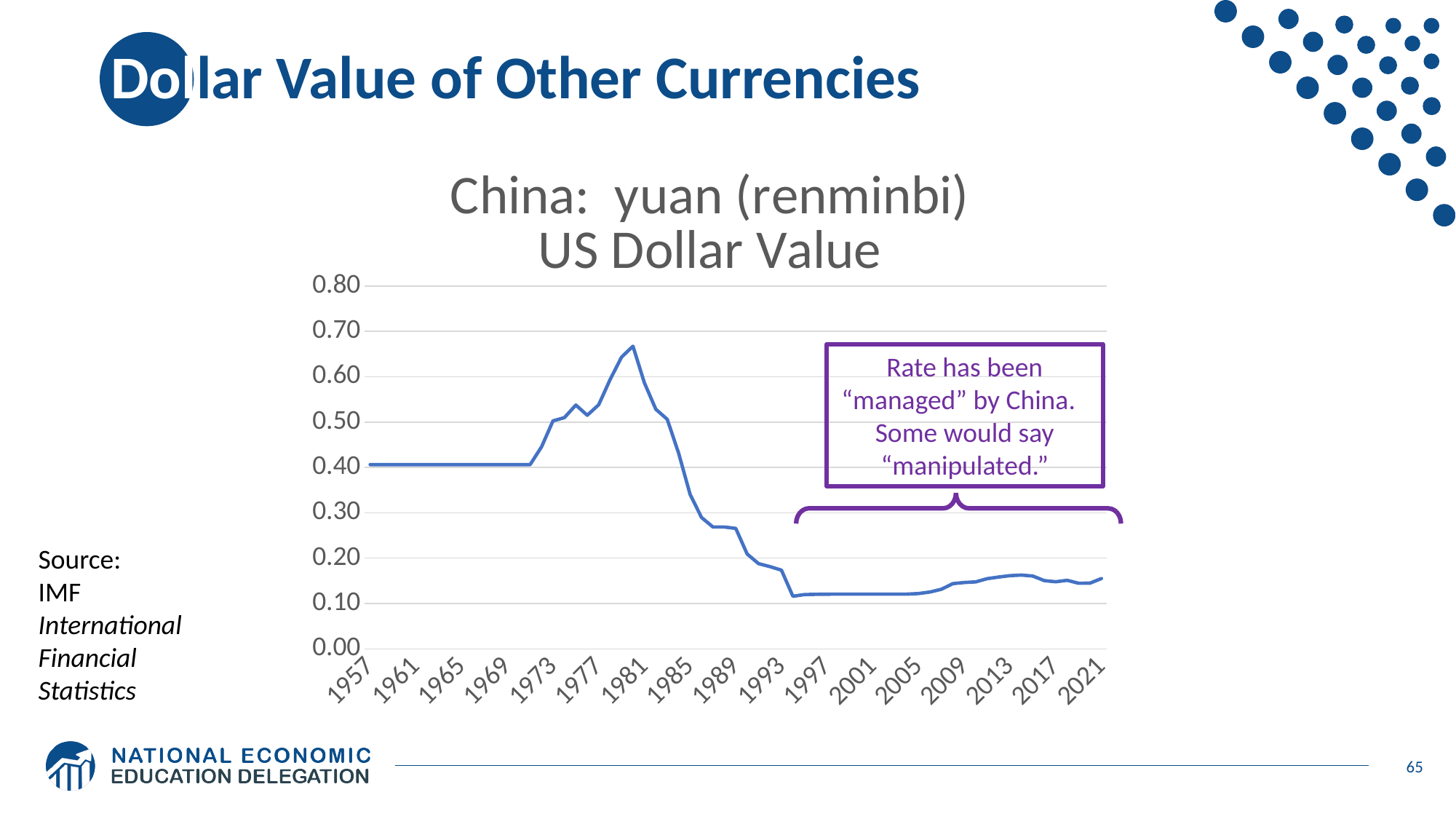
Is the value for 1957 greater or less than 0.30? greater What is the title of the chart? China: yuan (renminbi) US Dollar Value Is the value for 2021 greater or less than 0.30? less In which year does the US dollar value of the yuan reach its highest point? 1980 Is the value for 1989 greater or less than 0.40? less Do the values rise or fall between 1981 and 1993? fall Which year has the larger value, 1973 or 2013? 1973 What is the highest value shown on the y axis? 0.80 How many year labels are shown on the x axis? 17 What kind of chart is shown on the slide? line chart